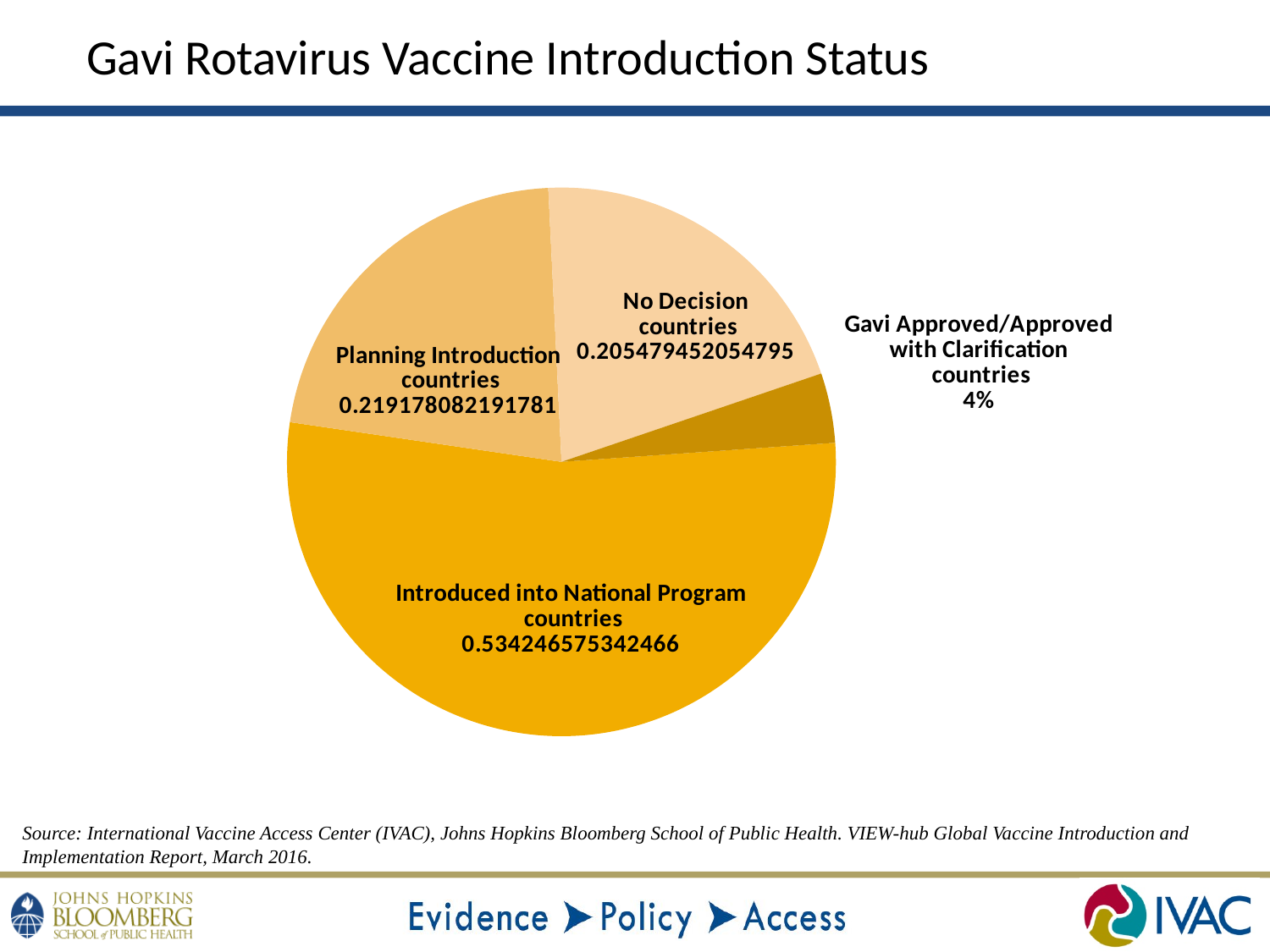
Which category has the smallest slice of the pie? Gavi Approved/Approved with Clarification countries What kind of chart is shown on the slide? Pie chart What is the title of the slide's chart? Gavi Rotavirus Vaccine Introduction Status Which category has the largest slice of the pie? Introduced into National Program countries What value is shown for Gavi Approved/Approved with Clarification countries? 4% What is the difference between the value for Introduced into National Program countries and the value for Planning Introduction countries? 0.315068493150685 What value is shown for Introduced into National Program countries? 0.534246575342466 What value is shown for Planning Introduction countries? 0.219178082191781 Which slice is the only one labeled with a percentage rather than a decimal? Gavi Approved/Approved with Clarification countries What value is shown for No Decision countries? 0.205479452054795 Which is larger, the value for Planning Introduction countries or the value for No Decision countries? Planning Introduction countries How many slices does the pie chart have? 4